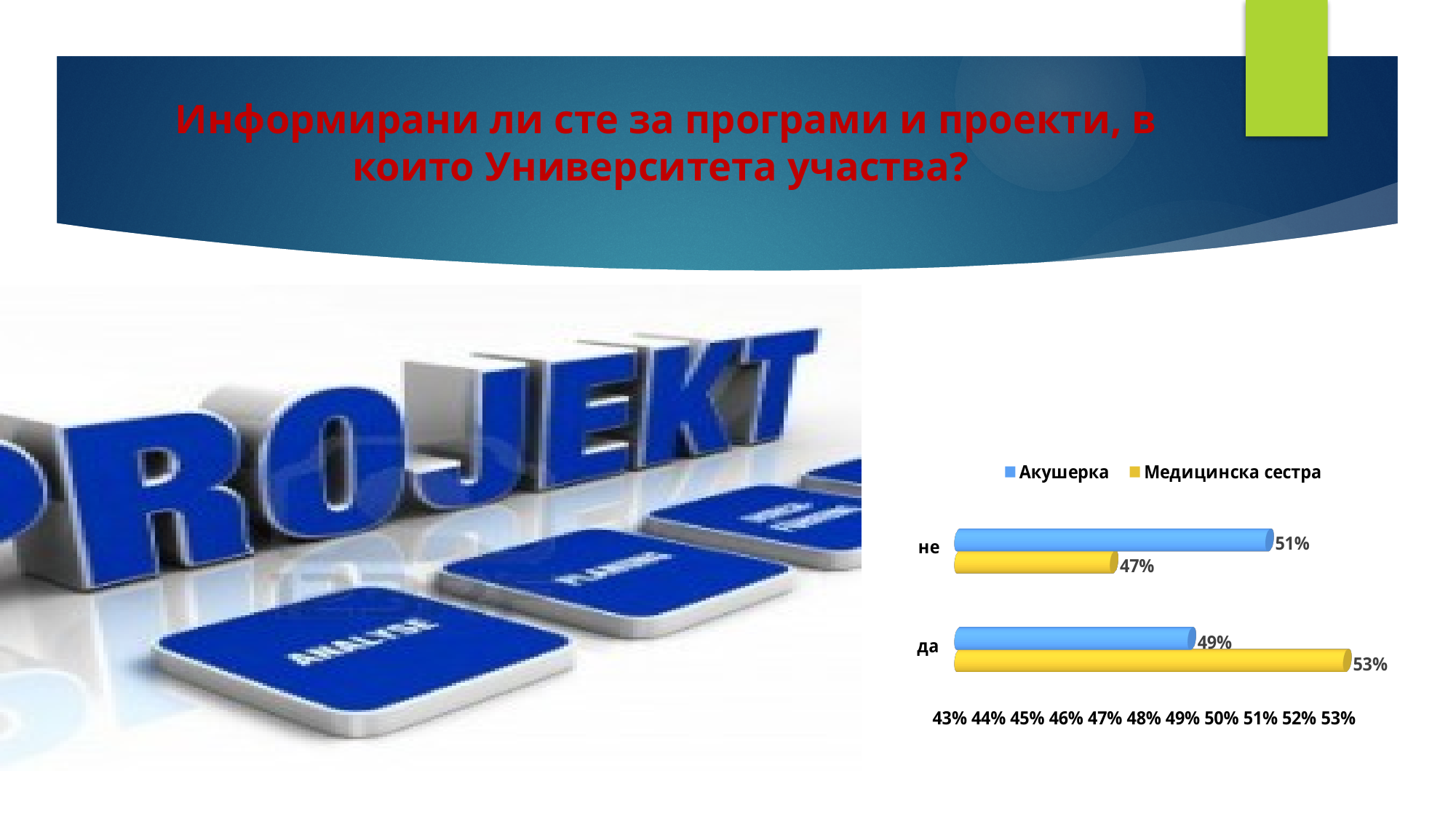
What is the difference between the Акушерка and Медицинска сестра values in the не category? 4% Which series has the higher value in the не category? Акушерка Which series has the higher value in the да category? Медицинска сестра What is the value for Медицинска сестра in the да category? 53% How many categories are shown on the chart? 2 What is the value for Акушерка in the да category? 49% How many series does the legend list? 2 What is the difference between the Медицинска сестра and Акушерка values in the да category? 4% What kind of chart is shown on the slide? Bar chart What is the value for Медицинска сестра in the не category? 47% Which category has the highest value for Медицинска сестра? да What is the value for Акушерка in the не category? 51%